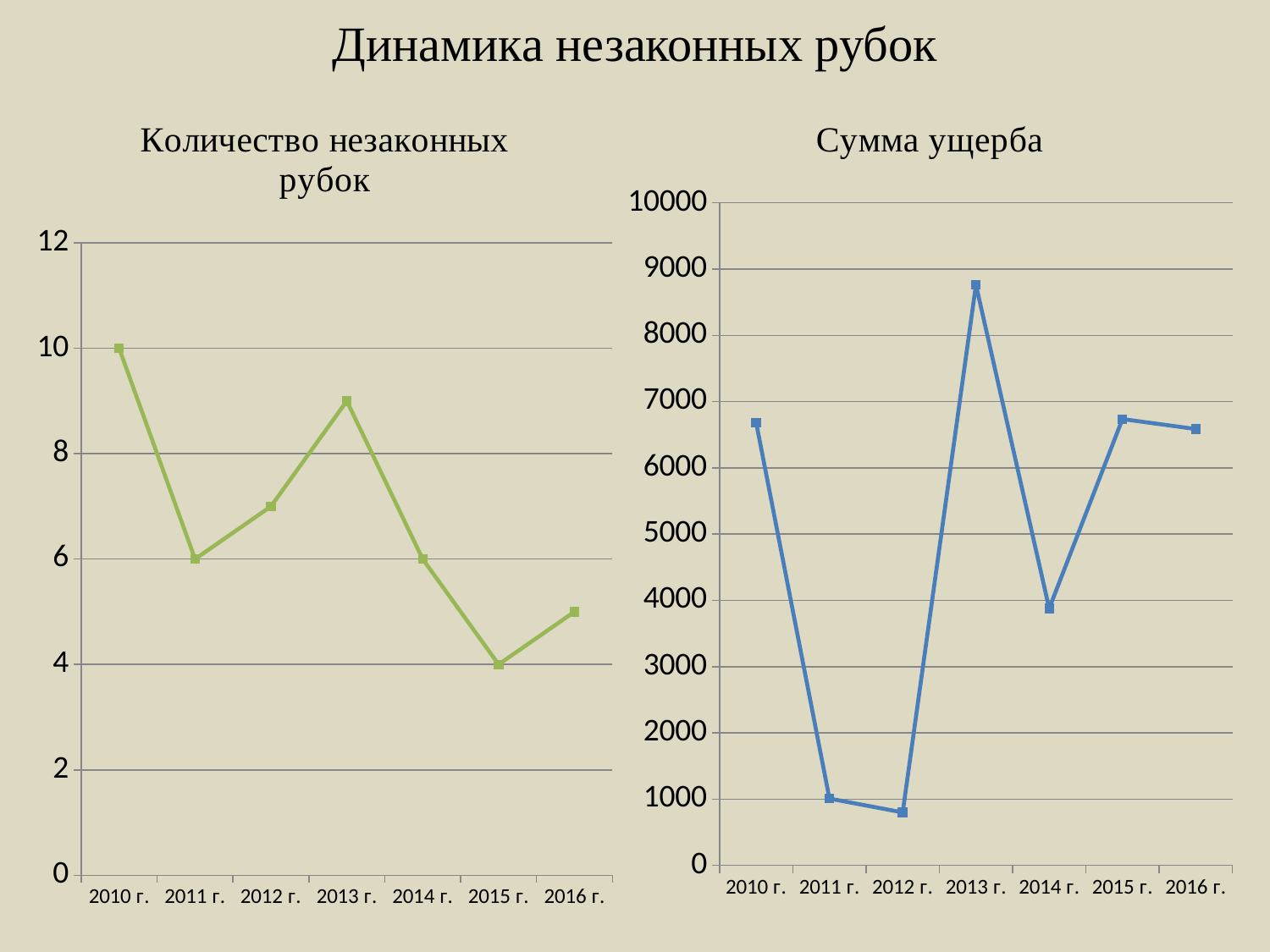
In the "Количество незаконных рубок" chart, which year has the lowest value? 2015 г. In the "Количество незаконных рубок" chart, which year has the highest value? 2010 г. In the "Количество незаконных рубок" chart, what is the value for 2015 г.? 4 What kind of chart is the "Количество незаконных рубок" chart on the left? line chart In the "Сумма ущерба" chart, which year has the highest value? 2013 г. In the "Сумма ущерба" chart, is the value for 2014 г. greater or less than 5000? less In the "Сумма ущерба" chart, which year has the lowest value? 2012 г. In the "Количество незаконных рубок" chart, what is the value for 2010 г.? 10 In the "Сумма ущерба" chart, is the value for 2013 г. greater or less than 8000? greater How many years are plotted in the "Количество незаконных рубок" chart? 7 In the "Количество незаконных рубок" chart, what is the difference between the values for 2010 г. and 2015 г.? 6 In the "Сумма ущерба" chart, which year has the larger value, 2010 г. or 2011 г.? 2010 г.